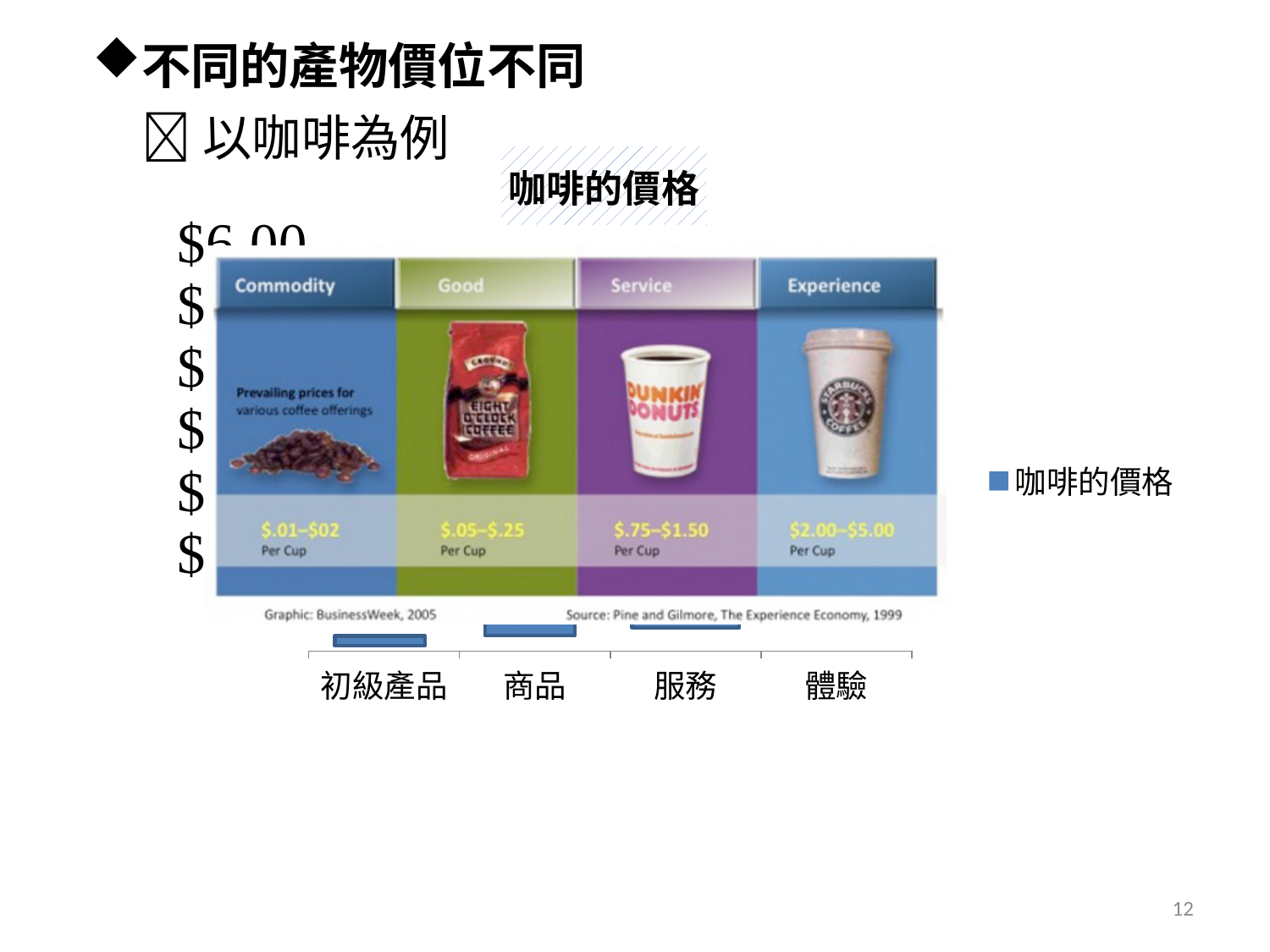
What series name appears in the chart's legend? 咖啡的價格 Is the value for 服務 greater or less than $6.00? less How many series does the chart's legend list? 1 Is the value for 初級產品 greater or less than $6.00? less What kind of chart is shown on the slide? bar chart Is the value for 商品 greater or less than $6.00? less How many categories are shown on the x axis of the chart? 4 What is the title of the chart? 咖啡的價格